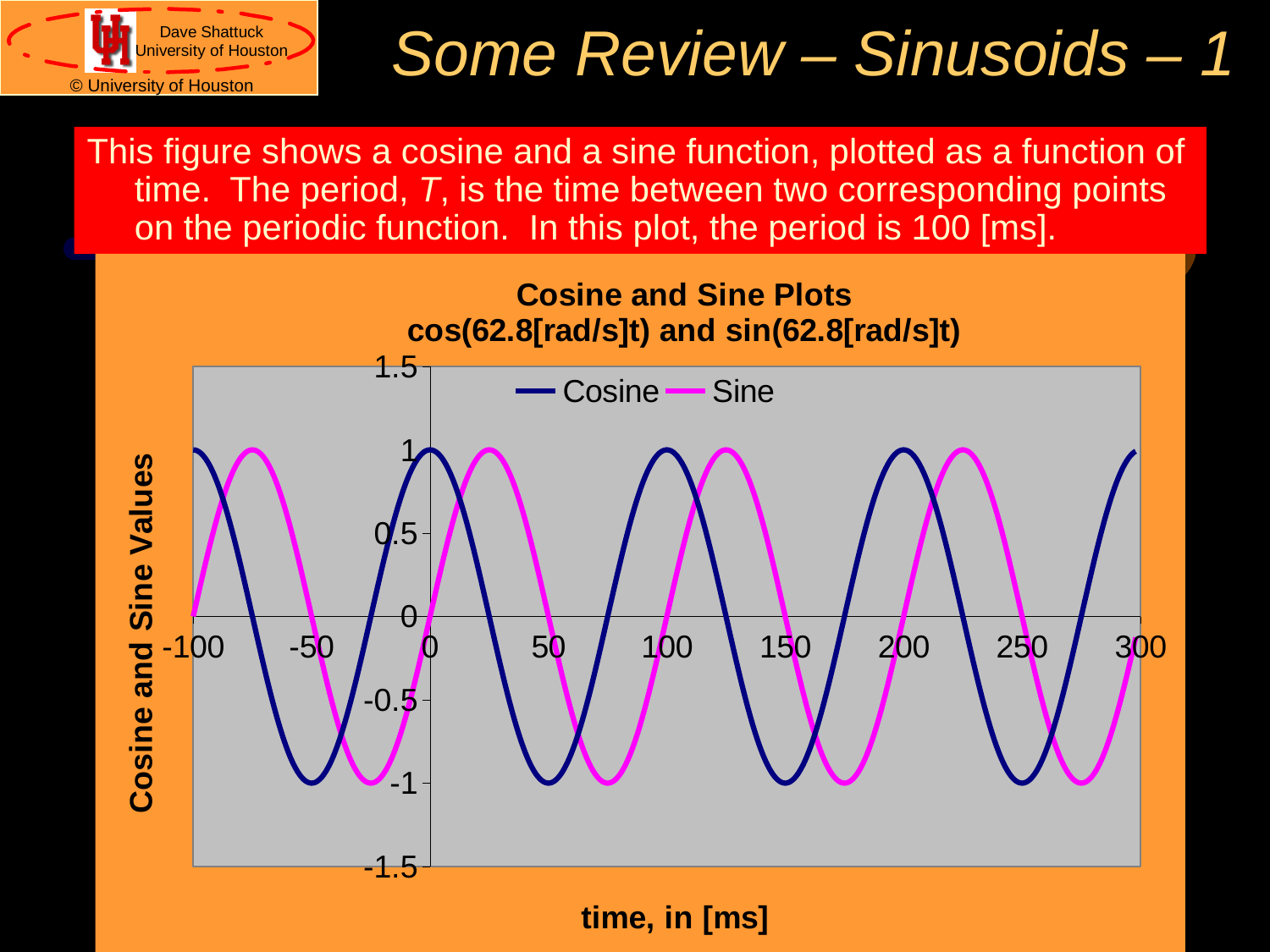
At time 0 ms, which series has the larger value, Cosine or Sine? Cosine What are the two series named in the chart legend? Cosine and Sine What is the value of the Sine series at time 100 ms? 0 What is the value of the Cosine series at time 0 ms? 1 Is the value of the Sine series at time 25 ms greater or less than 0.5? greater What is the value of the Cosine series at time 50 ms? -1 What is the value of the Sine series at time 0 ms? 0 What kind of chart is shown on the slide? line chart How many series does the chart legend list? 2 What colour is the Sine line in the chart? magenta What is the maximum value reached by the Cosine series? 1 What is the minimum value reached by the Sine series? -1